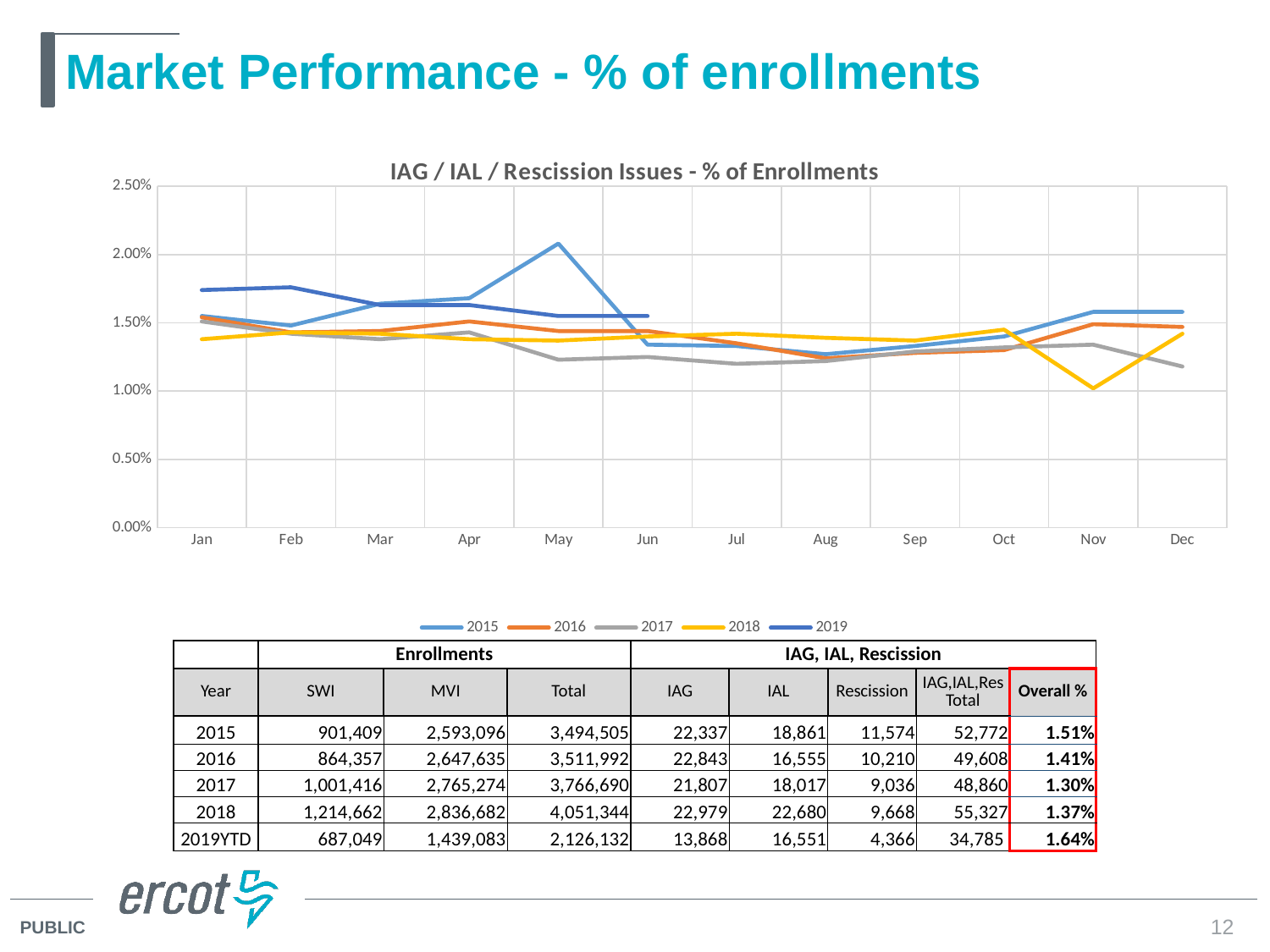
In May, which series has the larger value, 2015 or 2018? 2015 Is the value for 2015 in May greater or less than 2.00%? greater Is the value for 2018 in Jan greater or less than 1.50%? less Is the value for 2019 in Jan greater or less than 1.50%? greater What kind of chart is shown on the slide? line chart What is the title of the chart? IAG / IAL / Rescission Issues - % of Enrollments How many series does the chart legend list? 5 Does the 2019 line generally rise or fall from Jan to Jun? fall How many months are shown along the x axis of the chart? 12 Which series has the lowest value in Nov? 2018 Which series reaches the highest value anywhere on the chart, and in which month? 2015, in May